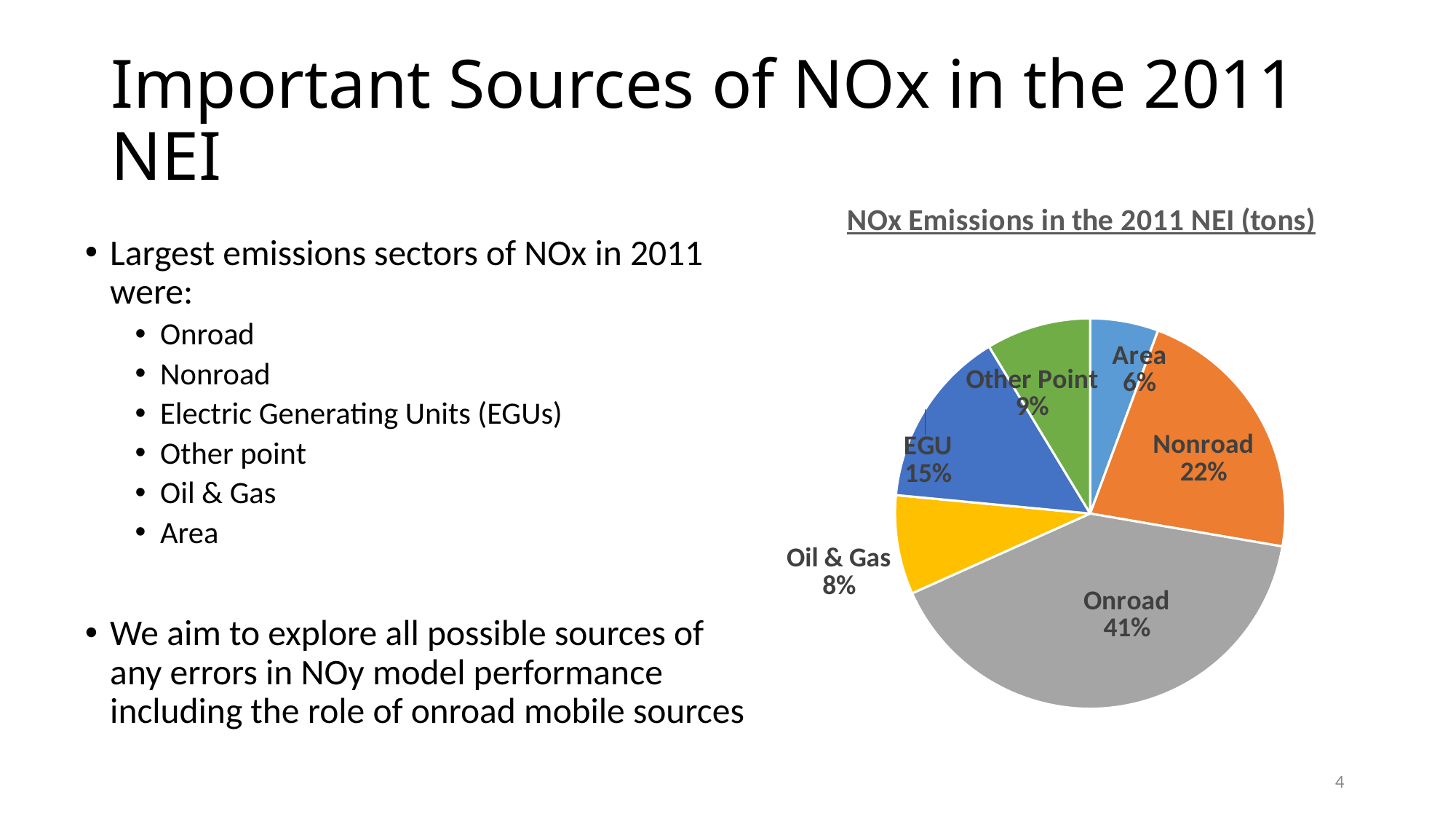
What type of chart is shown on the slide? pie chart What share of NOx emissions does Onroad account for? 41% What percentage is shown for Area? 6% What share of NOx emissions does Nonroad account for? 22% Which sector has the smallest share of NOx emissions? Area How many sectors are shown in the pie chart? 6 What percentage is shown for EGU? 15% Which has a larger share, Other Point or Oil & Gas? Other Point Which sector has the largest share of NOx emissions? Onroad What percentage is shown for Oil & Gas? 8% What is the chart's title? NOx Emissions in the 2011 NEI (tons) What is the difference in percentage points between Onroad and Nonroad? 19